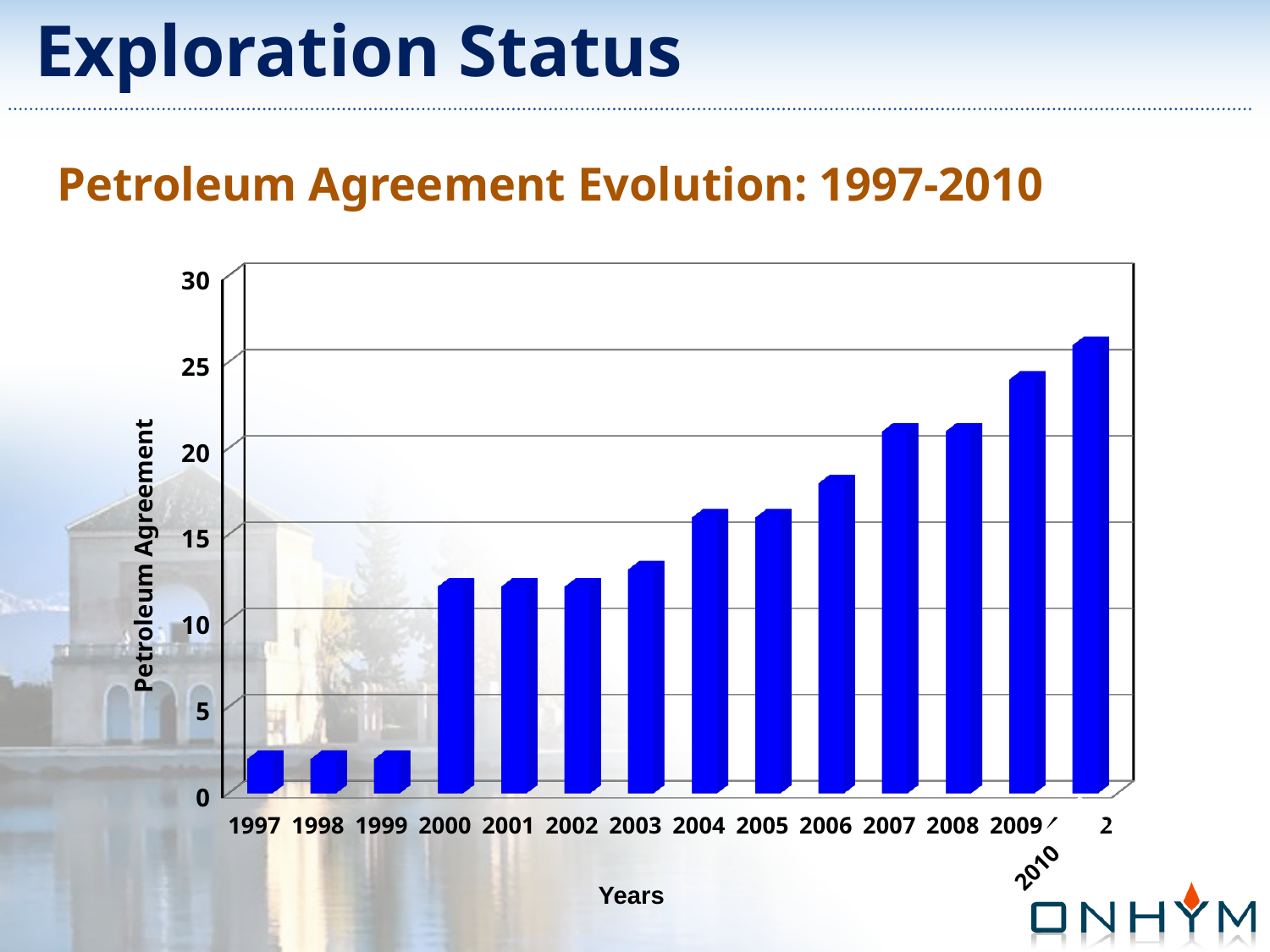
What kind of chart is shown on the slide? bar chart What is the label of the vertical axis? Petroleum Agreement Which year has the larger value, 2005 or 2009? 2009 Is the value for 2006 greater or less than 20? less Is the value for 2003 greater or less than 15? less Which year has the larger value, 2006 or 2003? 2006 Which year has the highest number of petroleum agreements? 2010 Is the value for 1997 greater or less than 5? less Do the values generally rise or fall from 1997 to 2010? rise How many years are shown on the x axis of the chart? 14